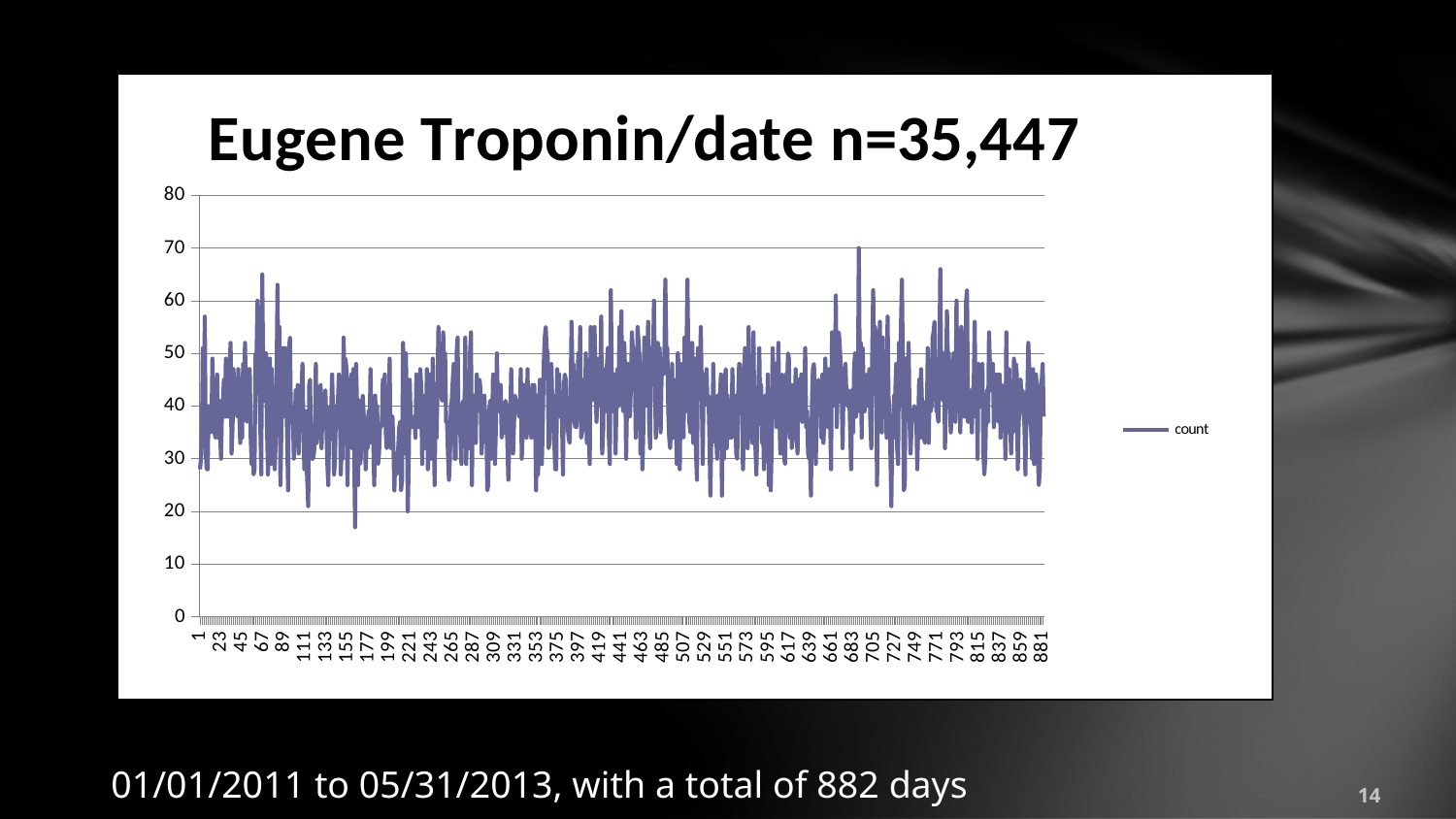
What is the last tick label shown on the x axis? 881 What is the title of the chart? Eugene Troponin/date n=35,447 Is the lowest value plotted on the chart greater or less than 20? less What is the highest tick value shown on the y axis? 80 What kind of chart is shown on the slide? line chart Is the highest value plotted on the chart greater or less than 60? greater What is the name of the series shown in the legend? count Is the highest value plotted on the chart greater or less than 80? less According to the caption below the chart, how many days does the data cover in total? 882 days How many series does the legend list? 1